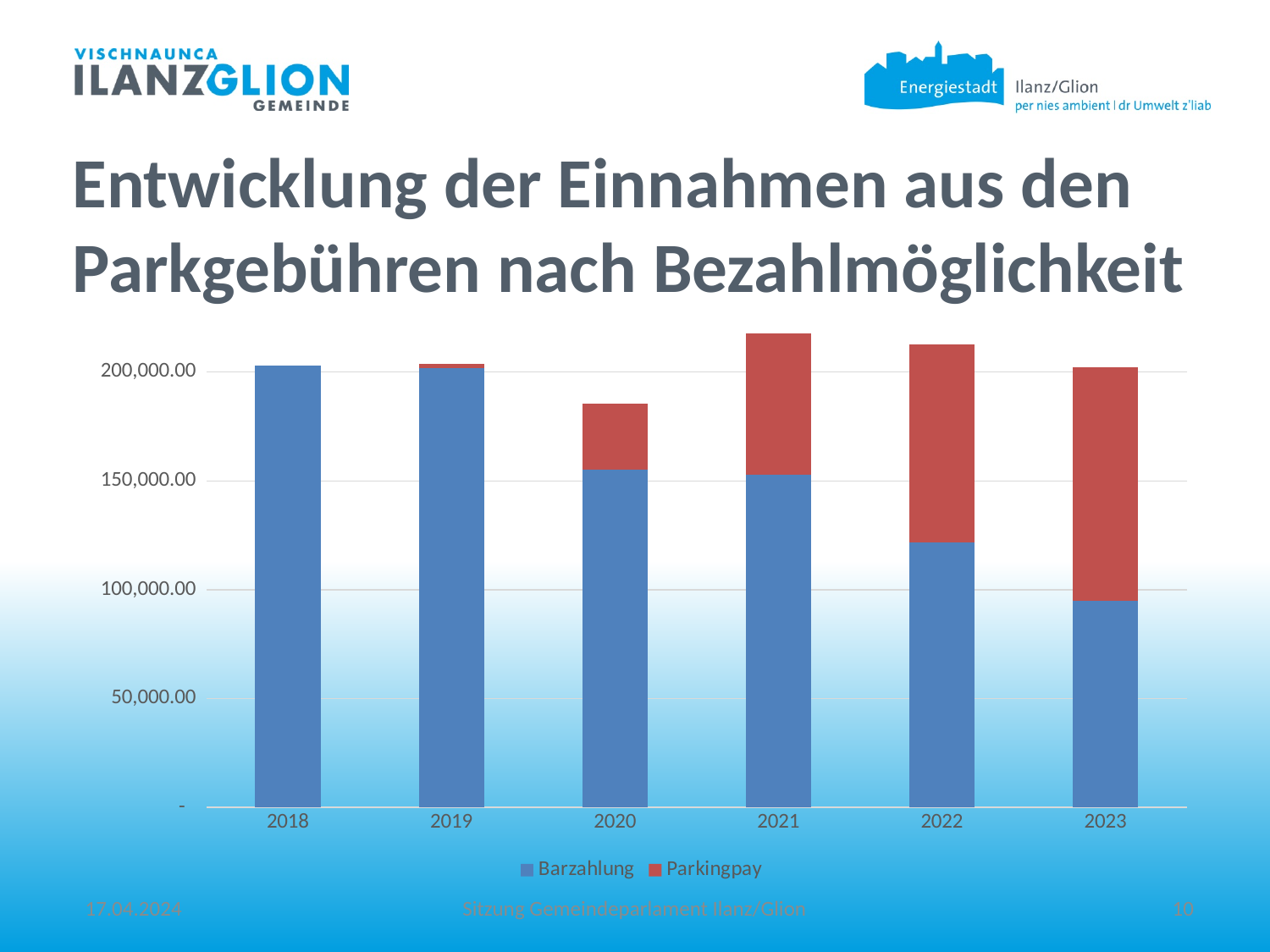
Is the total bar for 2021 greater or less than 200,000.00? greater Which year has the lowest total bar? 2020 Does the Barzahlung value rise or fall from 2018 to 2023? fall How many series does the legend list? 2 Which year has the largest Parkingpay segment? 2023 Which is larger, the Barzahlung value for 2020 or for 2022? 2020 What kind of chart is shown on the slide? Stacked bar chart Is the Barzahlung value for 2023 greater or less than 100,000.00? less Is the Barzahlung value for 2020 greater or less than 150,000.00? greater How many years are shown on the x axis? 6 Which year has the lowest Barzahlung value? 2023